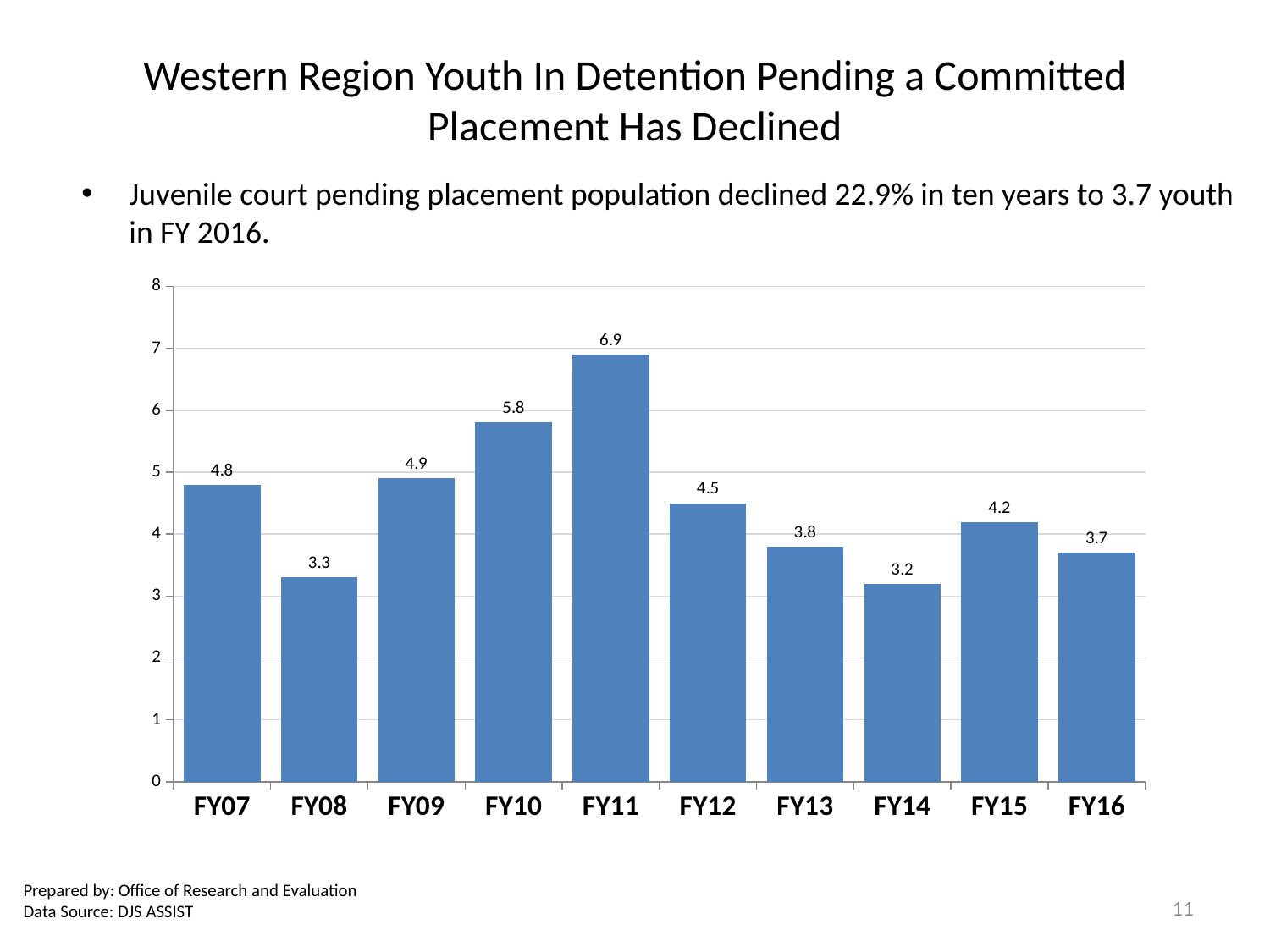
What is the value for FY11? 6.9 What kind of chart is shown on the slide? bar chart Which is larger, the value for FY10 or the value for FY12? FY10 What is the difference between the values for FY11 and FY14? 3.7 Do the values rise or fall from FY11 to FY14? fall Is the value for FY13 greater or less than 4? less What is the value for FY08? 3.3 Which fiscal year has the lowest value? FY14 What is the difference between the values for FY07 and FY16? 1.1 How many fiscal years are shown on the x axis? 10 What is the value for FY16? 3.7 Which fiscal year has the highest value? FY11